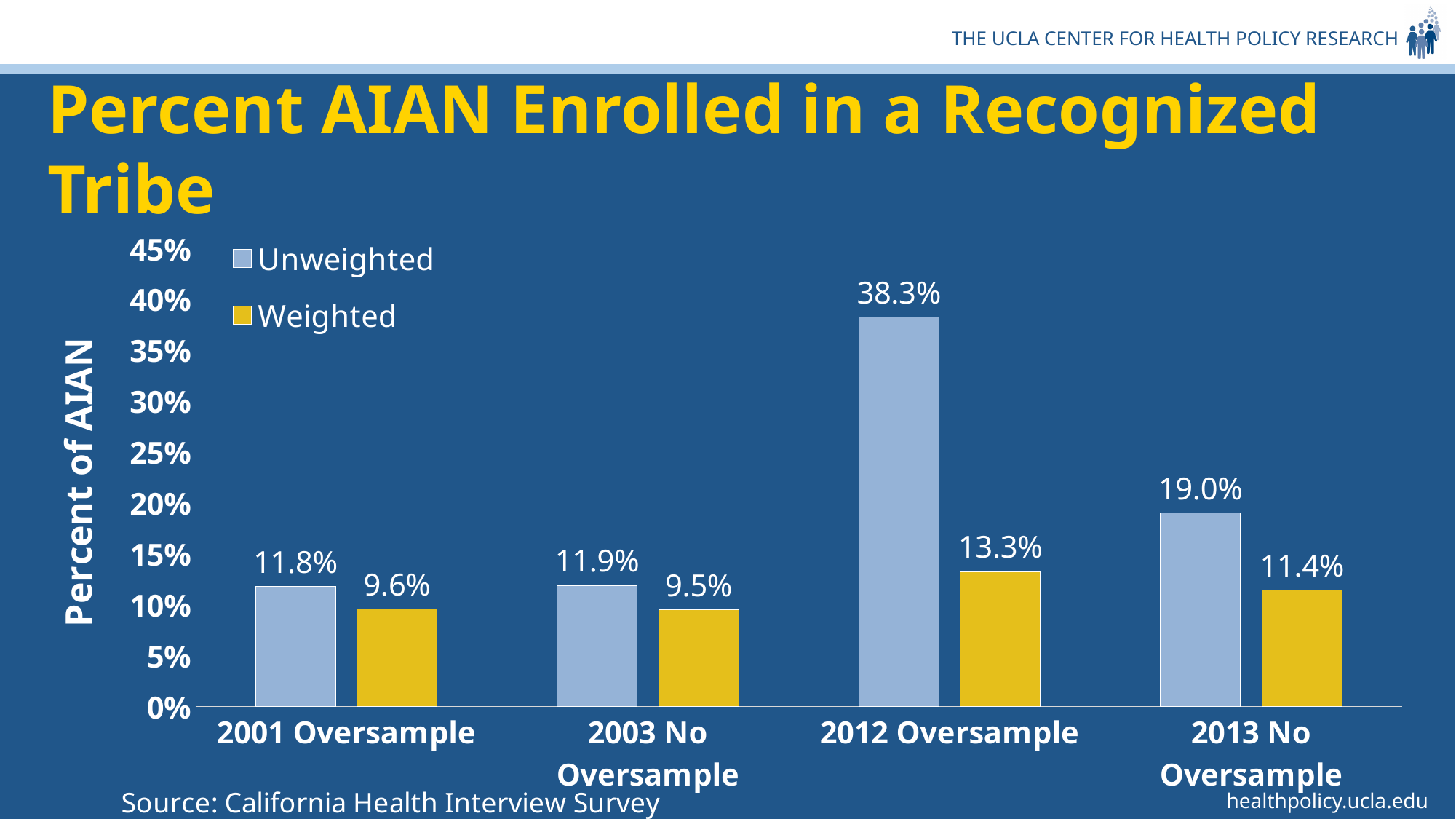
Is the Unweighted value for 2013 No Oversample greater or less than 15%? greater How many series does the legend list? 2 Which is larger, the Weighted value for 2012 Oversample or the Weighted value for 2013 No Oversample? 2012 Oversample What is the Weighted value for 2013 No Oversample? 11.4% How many categories are shown on the x axis? 4 What is the Unweighted value for 2012 Oversample? 38.3% What is the difference between the Unweighted and Weighted values for 2012 Oversample? 25.0% Which category has the lowest Weighted value? 2003 No Oversample What kind of chart is shown on the slide? bar chart What is the Weighted value for 2003 No Oversample? 9.5% Which category has the highest Unweighted value? 2012 Oversample What is the difference between the Unweighted values for 2013 No Oversample and 2001 Oversample? 7.2%